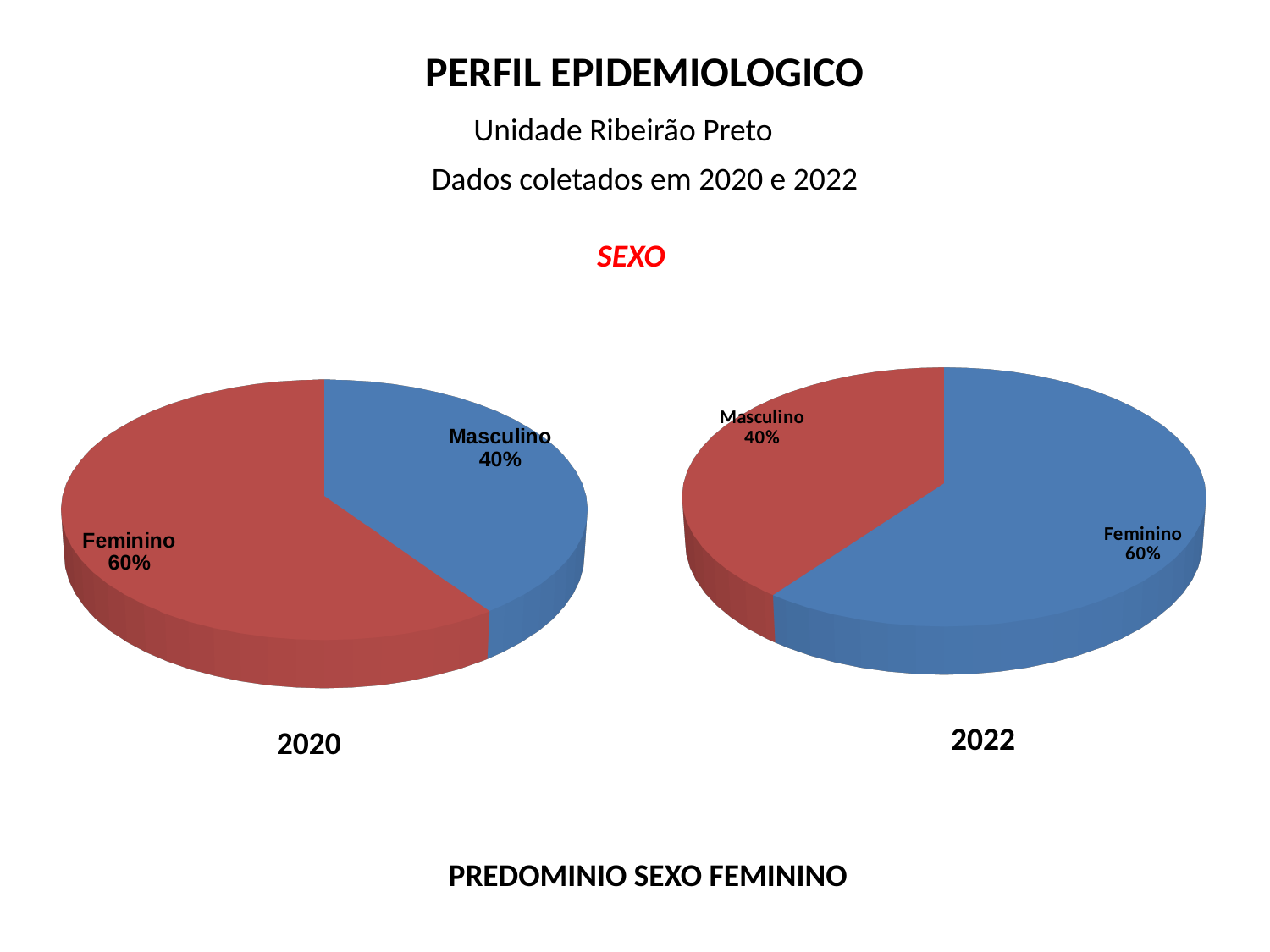
In the 2022 pie chart, which is larger, Feminino or Masculino? Feminino In the 2022 pie chart, what is the share for Masculino? 40% In the 2022 pie chart, which category has the smallest slice? Masculino In the 2022 pie chart, what colour is the Masculino slice? Red In the 2022 pie chart, what is the share for Feminino? 60% In the 2020 pie chart, what colour is the Feminino slice? Red In the 2020 pie chart, what is the difference in percentage points between Feminino and Masculino? 20 percentage points How many slices does the 2020 pie chart have? 2 In the 2020 pie chart, what is the share for Masculino? 40% What type of chart is the 2022 chart? Pie chart In the 2020 pie chart, what is the share for Feminino? 60% In the 2020 pie chart, which category has the largest slice? Feminino